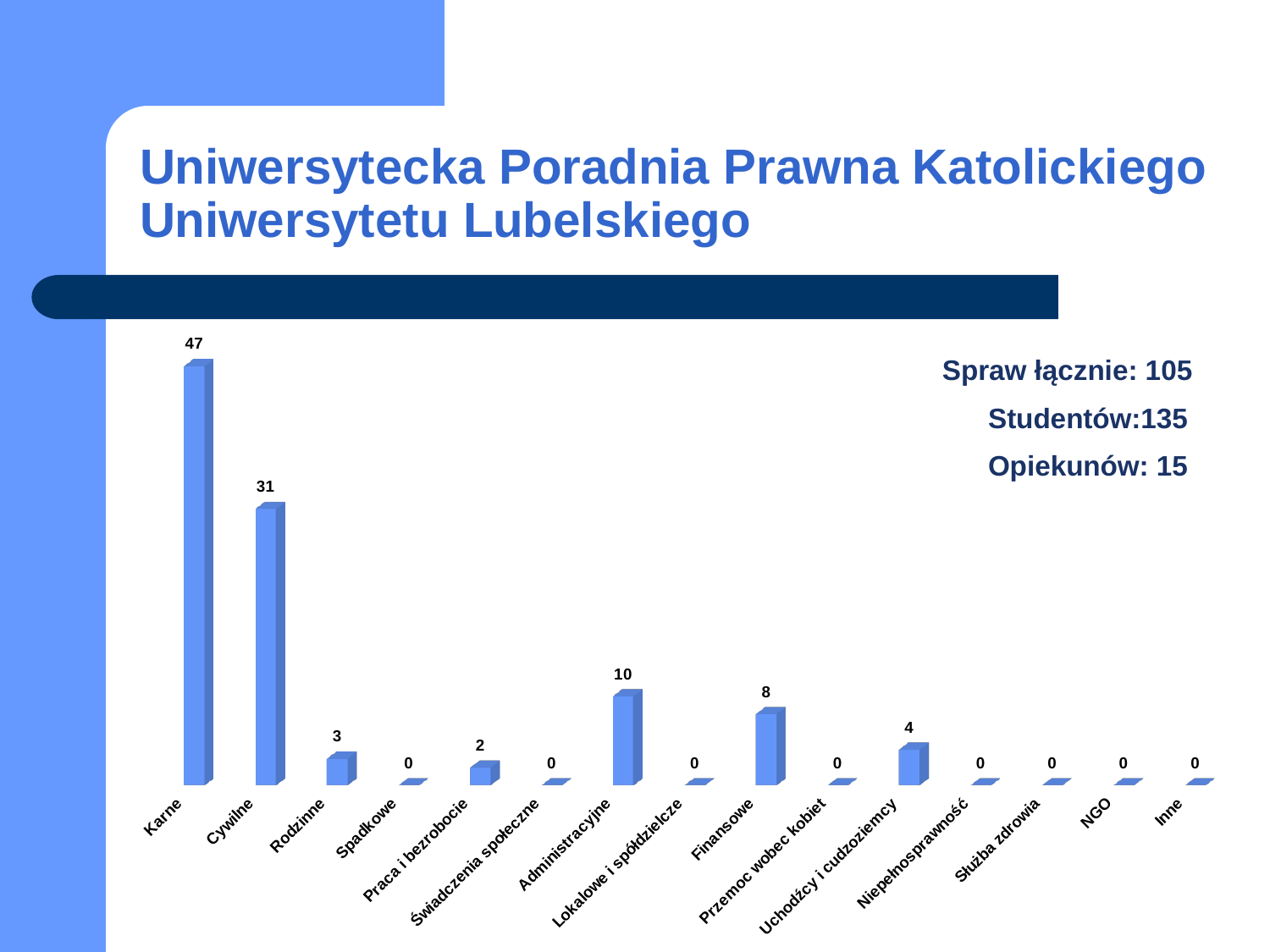
What type of chart is shown on the slide? bar chart Which is larger, the value for Finansowe or the value for Rodzinne? Finansowe Which category has the highest value? Karne What is the value for Praca i bezrobocie? 2 What is the difference between the values for Administracyjne and Finansowe? 2 What is the value for Administracyjne? 10 What is the value for Cywilne? 31 What is the difference between the values for Karne and Cywilne? 16 What is the value for Karne? 47 What is the value for Uchodźcy i cudzoziemcy? 4 How many categories are shown on the x axis? 15 How many categories have a value of 0? 8